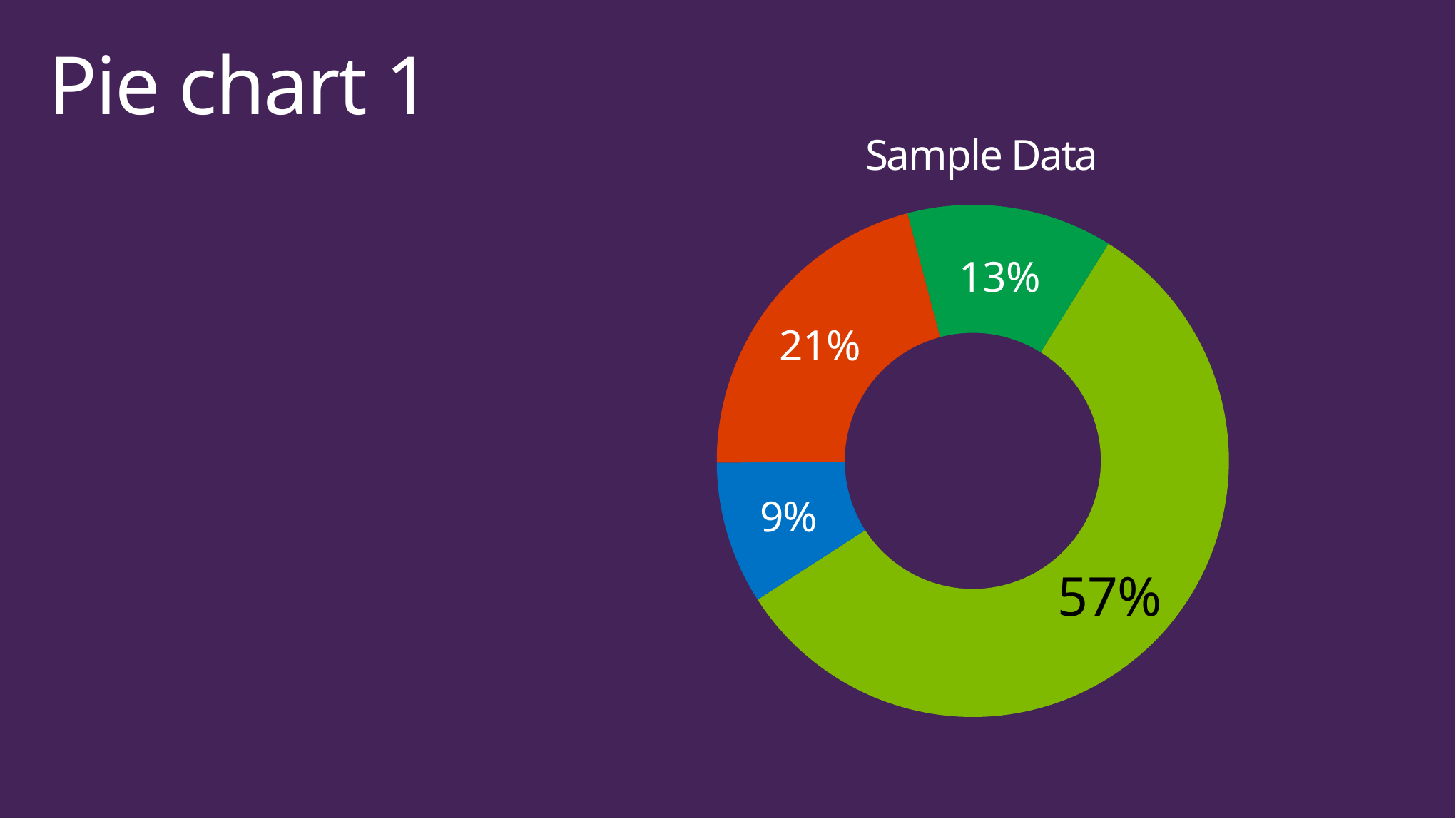
What percentage is shown on the dark green slice? 13% What is the largest share shown in the chart? 57% What colour is the largest slice of the chart? Light green How many slices does the chart have? 4 What percentage is shown on the blue slice? 9% What percentage is shown on the orange-red slice? 21% What is the title of the chart? Sample Data What is the smallest share shown in the chart? 9% Which slice is larger, the orange-red slice or the dark green slice? The orange-red slice (21%) What kind of chart is shown on the slide? Doughnut (pie) chart What percentage is shown on the light green slice? 57% What is the difference in percentage points between the largest slice (57%) and the orange-red slice (21%)? 36